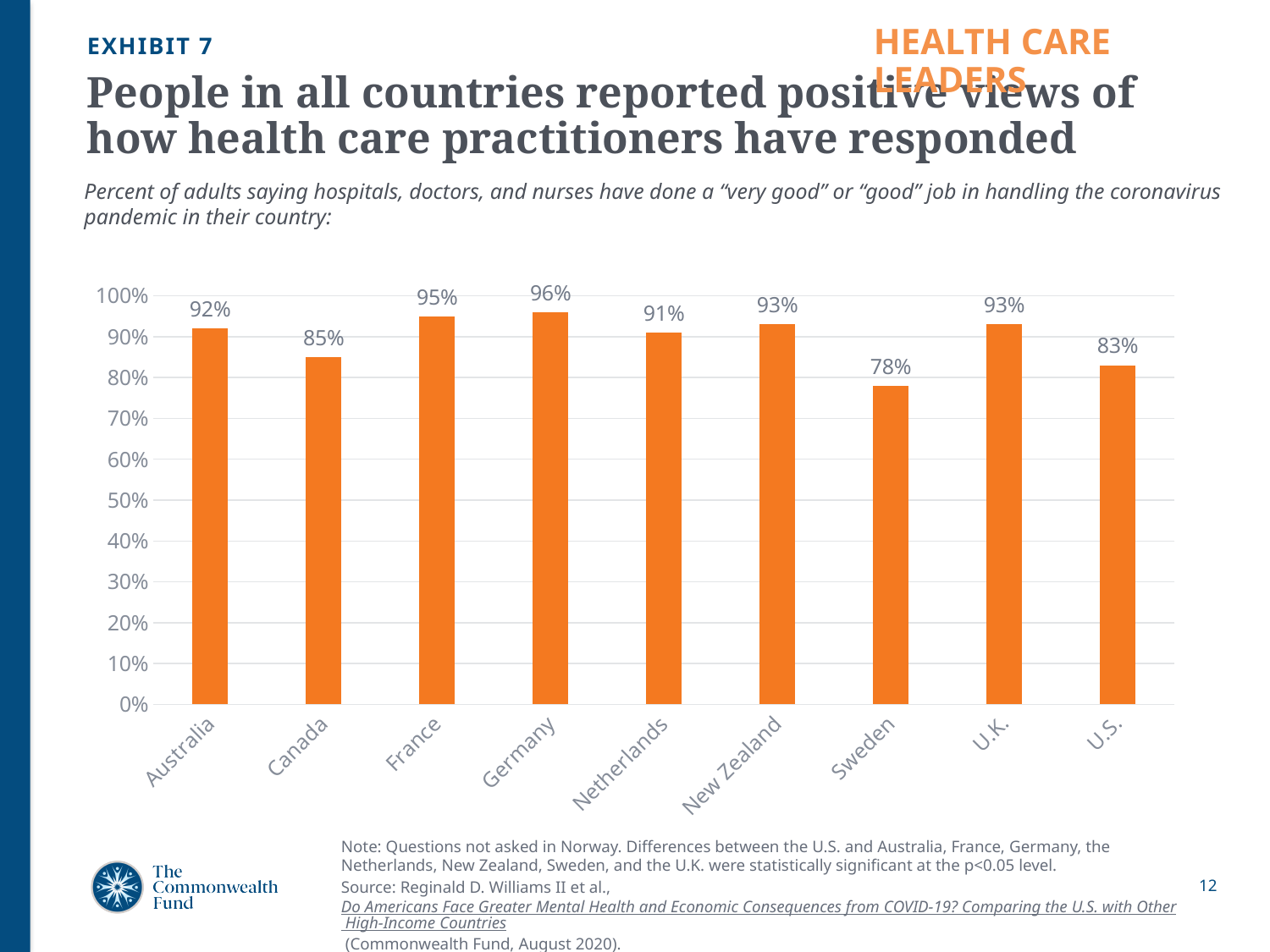
Which country has the lowest value in the chart? Sweden What kind of chart is shown on the slide? Bar chart What is the value shown for the U.S.? 83% How many countries are shown in the chart? 9 What colour are the bars in the chart? Orange Which has a higher value, Canada or France? France What is the value shown for Sweden? 78% Which country has the highest value in the chart? Germany What is the difference between the values for Germany and the U.S.? 13 percentage points Is the value for Sweden greater or less than 80%? less What is the difference between the values for New Zealand and Canada? 8 percentage points What percentage of adults in Australia said hospitals, doctors, and nurses have done a very good or good job? 92%